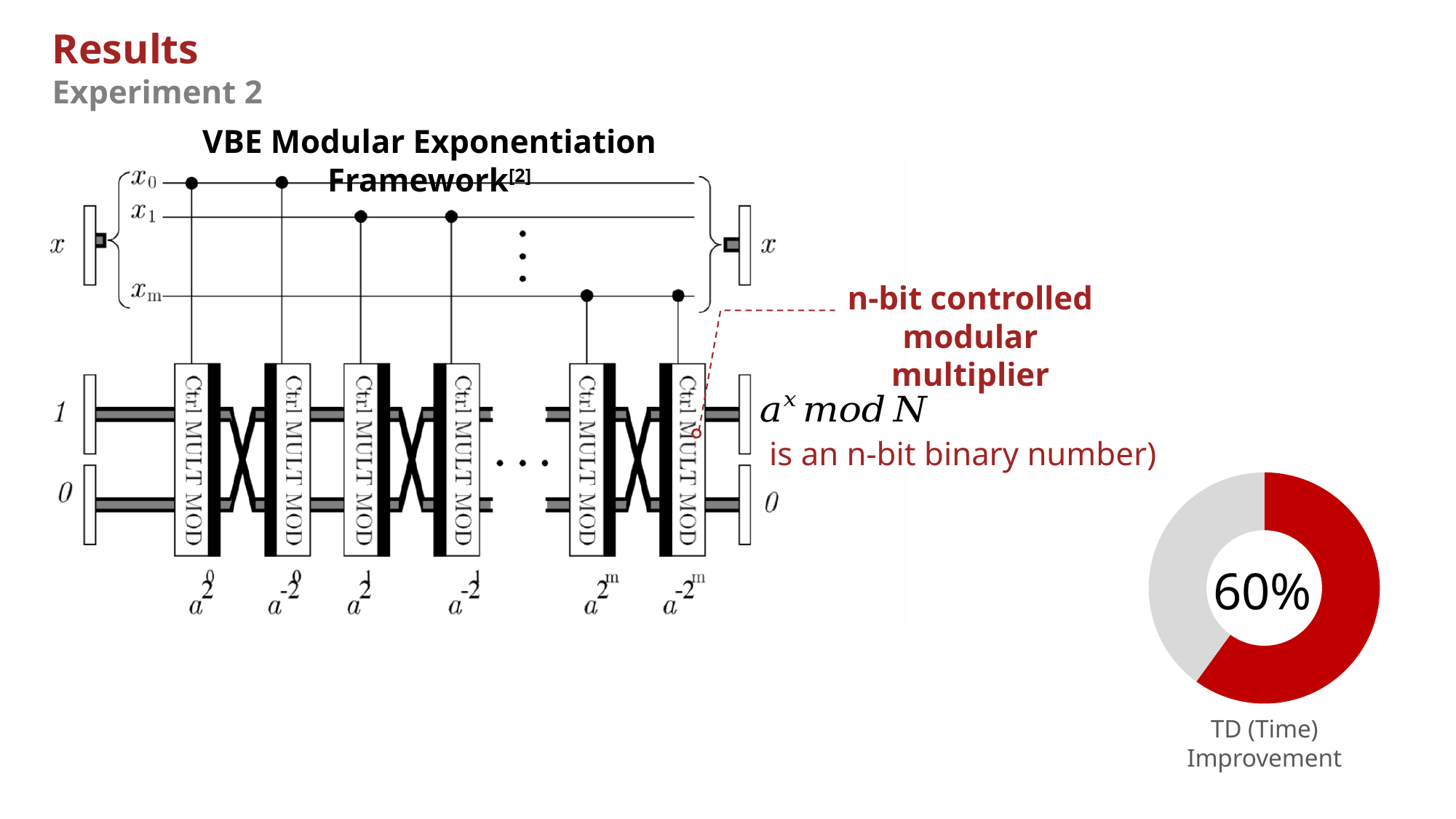
How many distinct segments does the donut chart have? 2 What kind of chart is shown at the bottom right of the slide? Donut chart Which segment of the donut chart is larger, the red one or the grey one? Red What share of the donut chart is filled by the red segment? 60% Is the TD (Time) Improvement value in the donut chart greater or less than 50%? greater What is the TD (Time) Improvement value shown in the donut chart? 60% What share of the donut chart is left unfilled (grey)? 40% What percentage is printed in the centre of the donut chart? 60% What colour is the filled portion of the donut chart representing the 60% improvement? Red What label appears beneath the donut chart? TD (Time) Improvement